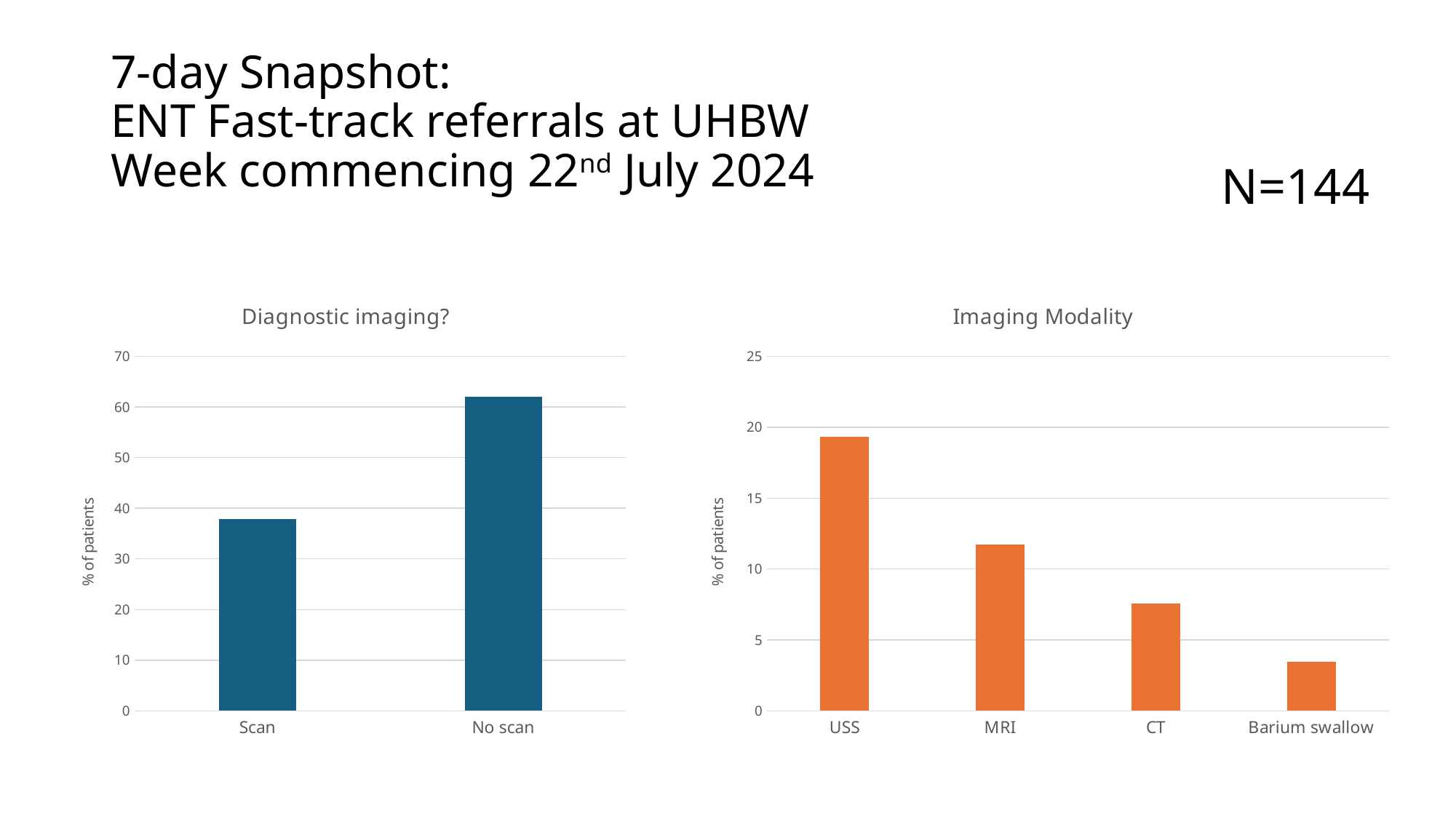
In the 'Diagnostic imaging?' chart, how many categories are plotted? 2 What is the y-axis label of the 'Imaging Modality' chart? % of patients In the 'Diagnostic imaging?' chart, is the value for No scan greater or less than 60? greater In the 'Imaging Modality' chart, which category has the highest value? USS In the 'Diagnostic imaging?' chart, what kind of chart is shown? bar chart In the 'Imaging Modality' chart, do the values rise or fall from left to right along the x axis? fall In the 'Imaging Modality' chart, which category has the lowest value? Barium swallow In the 'Diagnostic imaging?' chart, which category has the higher value? No scan In the 'Diagnostic imaging?' chart, is the value for Scan greater or less than 40? less In the 'Imaging Modality' chart, is the value for USS greater or less than 20? less In the 'Imaging Modality' chart, how many categories are plotted? 4 In the 'Imaging Modality' chart, which is larger, the value for MRI or the value for CT? MRI